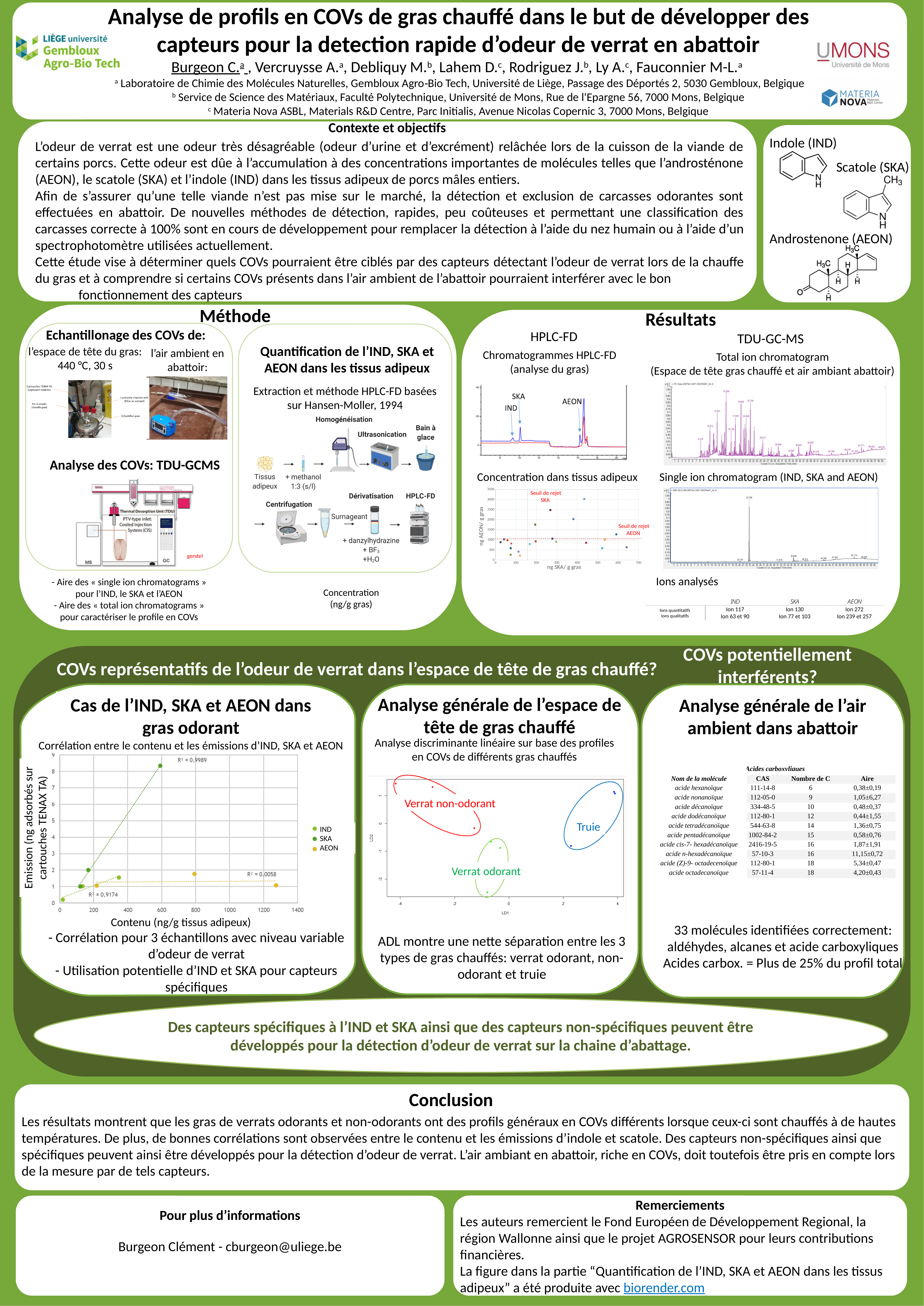
What kind of chart is 'Corrélation entre le contenu et les émissions d'IND, SKA et AEON'? Scatter chart In the chart 'Corrélation entre le contenu et les émissions d'IND, SKA et AEON', what is the lowest R² value printed? R² = 0,0058 In the linear discriminant analysis chart under 'Analyse générale de l'espace de tête de gras chauffé', how many groups of heated fat are circled? 3 In the chart 'Corrélation entre le contenu et les émissions d'IND, SKA et AEON', how many series does the legend list? 3 In the chart 'Corrélation entre le contenu et les émissions d'IND, SKA et AEON', is the emission value of the AEON point at the far right (around 1280 ng/g) greater or less than 2? less In the chart 'Corrélation entre le contenu et les émissions d'IND, SKA et AEON', what is the highest R² value printed? R² = 0,9989 In the linear discriminant analysis chart under 'Analyse générale de l'espace de tête de gras chauffé', which group lies at the highest LD1 values (far right)? Truie In the chart 'Corrélation entre le contenu et les émissions d'IND, SKA et AEON', what are the legend entries? IND, SKA, AEON In the chart 'Concentration dans tissus adipeux', what is the highest tick value shown on the y axis (ng AEON/ g gras)? 3500 In the chart 'Corrélation entre le contenu et les émissions d'IND, SKA et AEON', is the emission value of the highest SKA point greater or less than 7? greater In the chart 'Corrélation entre le contenu et les émissions d'IND, SKA et AEON', what is the x-axis title? Contenu (ng/g tissus adipeux) In the HPLC-FD chromatogram (analyse du gras), which labeled peak appears furthest to the right? AEON